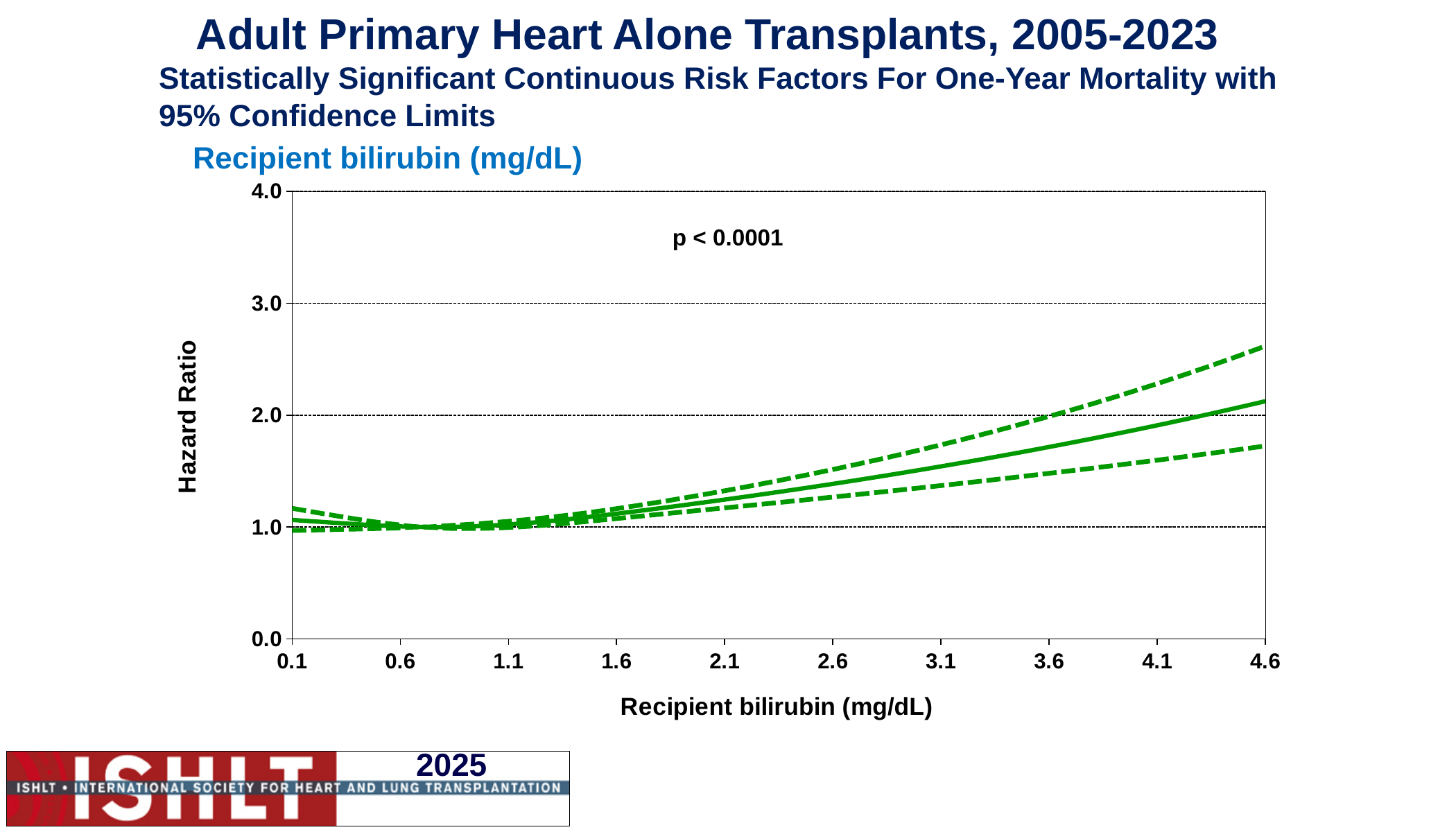
What kind of chart is shown on the slide? line chart Is the upper dashed confidence limit at a recipient bilirubin of 4.6 mg/dL greater or less than 2.0? greater Does the solid hazard ratio line rise or fall as recipient bilirubin increases from 1.6 to 4.6 mg/dL? rise How many lines are plotted on the chart? 3 Is the hazard ratio on the solid line at a recipient bilirubin of 4.6 mg/dL greater or less than 3.0? less How many tick labels are shown on the x axis (Recipient bilirubin)? 10 Which is larger at a recipient bilirubin of 4.6 mg/dL: the upper dashed line or the lower dashed line? upper dashed line Is the lower dashed confidence limit at a recipient bilirubin of 4.6 mg/dL greater or less than 2.0? less What is the title of the chart? Recipient bilirubin (mg/dL) What p-value is printed on the chart? p < 0.0001